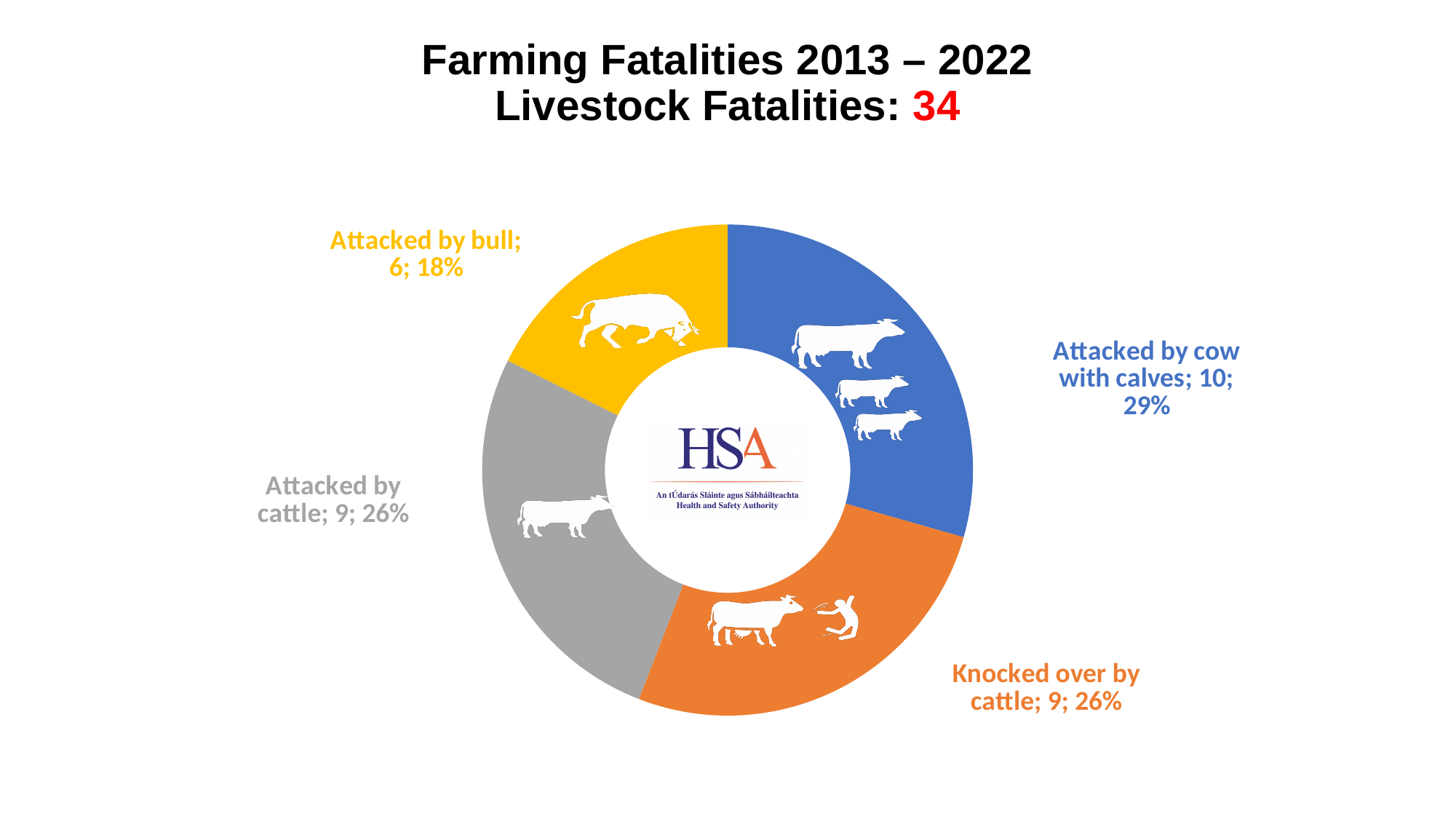
How many fatalities were caused by being knocked over by cattle? 9 What is the total number of livestock fatalities stated in the chart title? 34 What kind of chart is shown on the slide? Pie chart (doughnut) How many categories does the chart show? 4 What share of livestock fatalities were due to being attacked by a cow with calves? 29% How many livestock fatalities were attributed to being attacked by a cow with calves? 10 Which category accounts for the largest share of livestock fatalities? Attacked by cow with calves How many fatalities were caused by being attacked by a bull? 6 What percentage of livestock fatalities were due to being attacked by cattle? 26% Which category accounts for the smallest share of livestock fatalities? Attacked by bull What is the difference between the number of fatalities from being attacked by a cow with calves and from being attacked by a bull? 4 Which is larger: fatalities from being attacked by a bull or from being knocked over by cattle? Knocked over by cattle